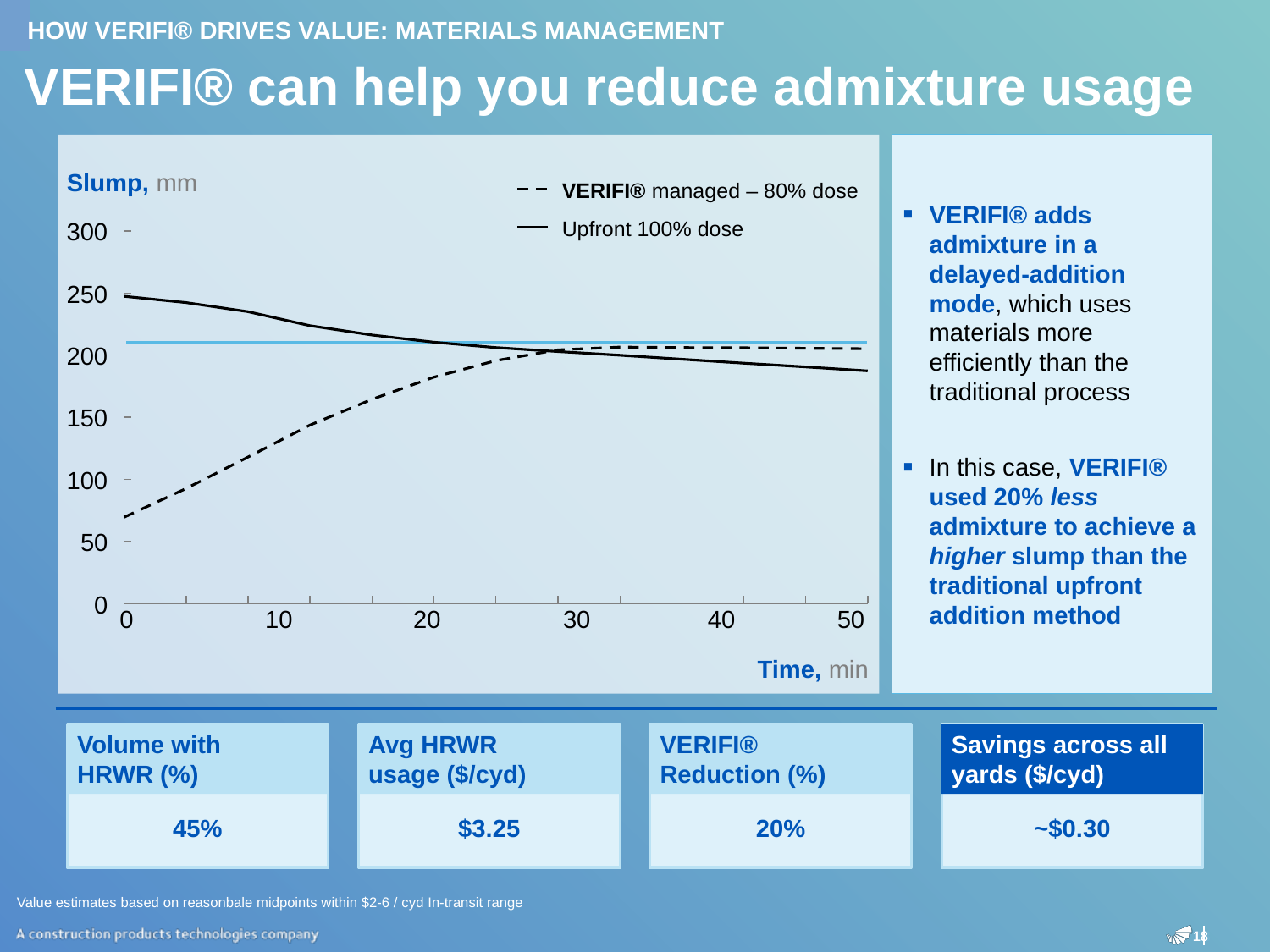
At time 0 min, which series has the higher slump: VERIFI® managed – 80% dose or Upfront 100% dose? Upfront 100% dose Which series is drawn with a dashed line? VERIFI® managed – 80% dose Does the Upfront 100% dose series rise or fall as time increases? fall At time 50 min, which series has the higher slump: VERIFI® managed – 80% dose or Upfront 100% dose? VERIFI® managed – 80% dose Is the slump for Upfront 100% dose at time 50 min greater or less than 200? less Is the slump for Upfront 100% dose at time 0 min greater or less than 200? greater What is the label of the y axis? Slump, mm Does the VERIFI® managed – 80% dose series rise or fall as time increases? rise Is the slump for VERIFI® managed – 80% dose at time 0 min greater or less than 100? less How many series does the chart legend list? 2 What kind of chart is shown on the slide? line chart